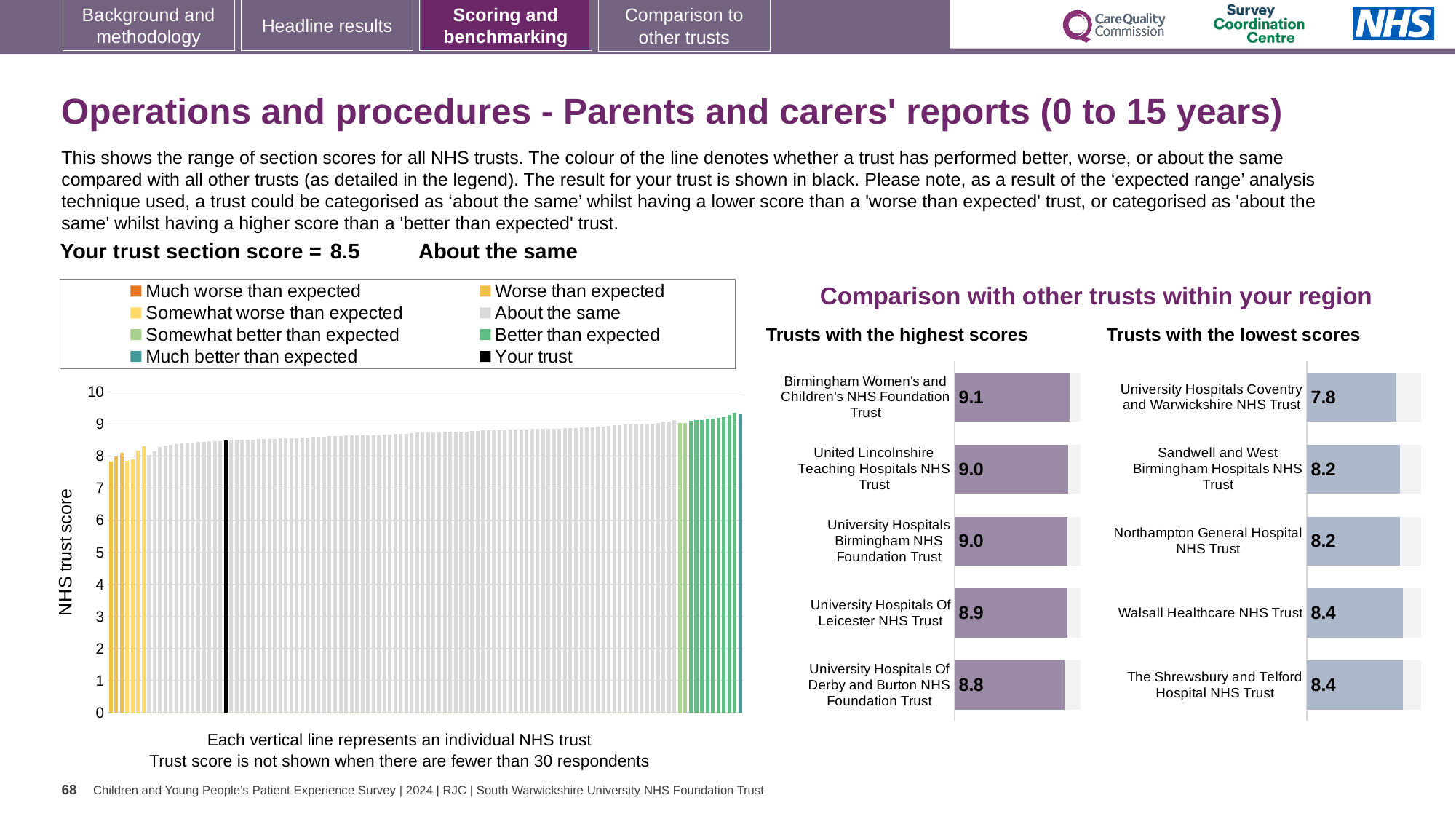
In the 'Trusts with the lowest scores' chart, which trust has the lowest score? University Hospitals Coventry and Warwickshire NHS Trust In the 'Trusts with the highest scores' chart, what is the difference between the scores of Birmingham Women's and Children's NHS Foundation Trust and University Hospitals Of Derby and Burton NHS Foundation Trust? 0.3 In the 'Trusts with the lowest scores' chart, what is the score for University Hospitals Coventry and Warwickshire NHS Trust? 7.8 How many trusts are shown in the 'Trusts with the highest scores' chart? 5 In the 'Trusts with the lowest scores' chart, which has the higher score: Sandwell and West Birmingham Hospitals NHS Trust or Walsall Healthcare NHS Trust? Walsall Healthcare NHS Trust In the 'Trusts with the highest scores' chart, what is the score for Birmingham Women's and Children's NHS Foundation Trust? 9.1 What kind of chart is the large 'NHS trust score' chart on the left of the slide? bar chart What is your trust's section score shown on the slide? 8.5 In the 'Trusts with the lowest scores' chart, what is the difference between the scores of Walsall Healthcare NHS Trust and University Hospitals Coventry and Warwickshire NHS Trust? 0.6 In the large 'NHS trust score' chart on the left, do the bars rise or fall from left to right? rise In the 'Trusts with the highest scores' chart, which trust has the highest score? Birmingham Women's and Children's NHS Foundation Trust How many entries does the legend above the large 'NHS trust score' chart list? 8